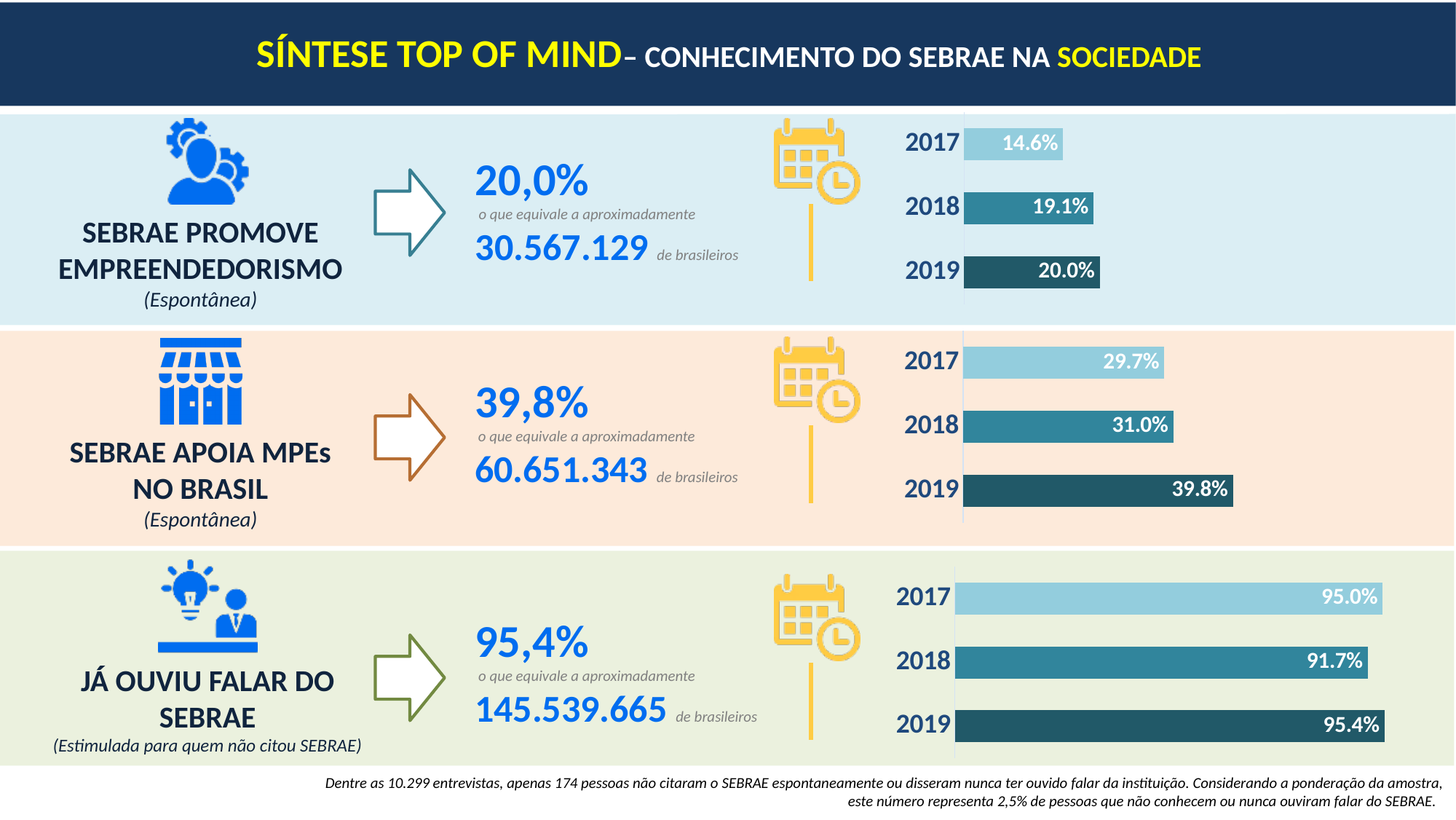
In the 'SEBRAE APOIA MPEs NO BRASIL' chart, how many years are shown? 3 What kind of chart is used in the 'SEBRAE PROMOVE EMPREENDEDORISMO' row? Bar chart In the 'JÁ OUVIU FALAR DO SEBRAE' chart, which is larger, the value for 2017 or 2018? 2017 In the 'SEBRAE APOIA MPEs NO BRASIL' chart, what is the value for 2018? 31.0% In the 'SEBRAE PROMOVE EMPREENDEDORISMO' chart, what is the difference between the 2019 and 2017 values? 5.4 percentage points In the 'SEBRAE APOIA MPEs NO BRASIL' chart, do the values rise or fall from 2017 to 2019? Rise In the 'JÁ OUVIU FALAR DO SEBRAE' chart, which year has the lowest value? 2018 In the 'SEBRAE PROMOVE EMPREENDEDORISMO' chart, which year has the highest value? 2019 How many bar charts are shown on the slide? 3 In the 'SEBRAE PROMOVE EMPREENDEDORISMO' chart, what is the value for 2017? 14.6% In the 'JÁ OUVIU FALAR DO SEBRAE' chart, what is the value for 2019? 95.4% In the 'SEBRAE APOIA MPEs NO BRASIL' chart, what is the difference between the 2019 and 2017 values? 10.1 percentage points